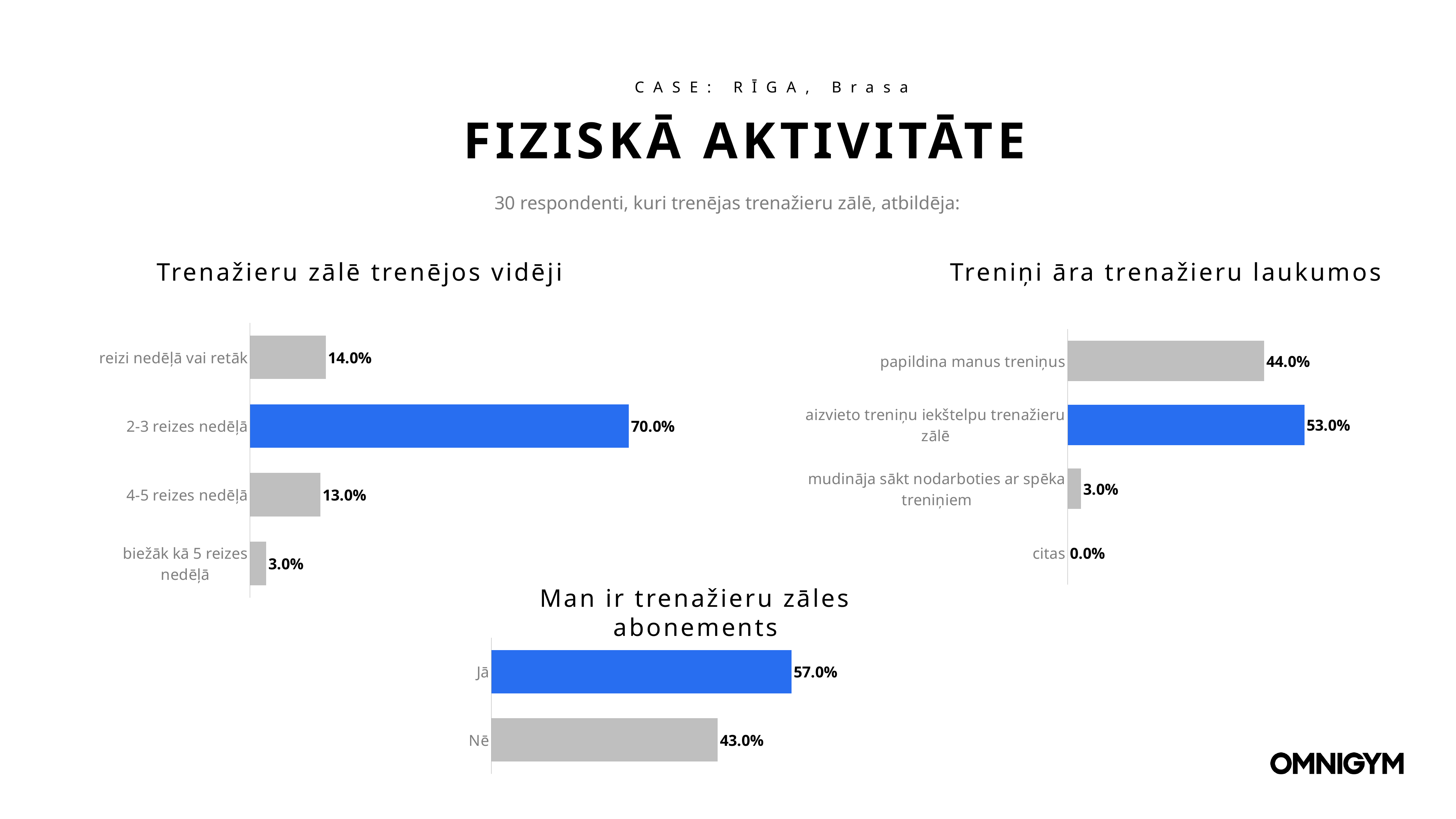
In the 'Trenažieru zālē trenējos vidēji' chart, which category has the lowest value? biežāk kā 5 reizes nedēļā In the 'Trenažieru zālē trenējos vidēji' chart, what is the value for '2-3 reizes nedēļā'? 70.0% In the 'Treniņi āra trenažieru laukumos' chart, what is the difference between 'aizvieto treniņu iekštelpu trenažieru zālē' and 'papildina manus treniņus'? 9.0% In the 'Treniņi āra trenažieru laukumos' chart, what is the value for 'papildina manus treniņus'? 44.0% In the 'Treniņi āra trenažieru laukumos' chart, what is the value for 'citas'? 0.0% In the 'Man ir trenažieru zāles abonements' chart, what is the value for 'Nē'? 43.0% In the 'Treniņi āra trenažieru laukumos' chart, which category has the highest value? aizvieto treniņu iekštelpu trenažieru zālē In the 'Trenažieru zālē trenējos vidēji' chart, which bar is coloured blue? 2-3 reizes nedēļā In the 'Man ir trenažieru zāles abonements' chart, which is larger, 'Jā' or 'Nē'? Jā In the 'Trenažieru zālē trenējos vidēji' chart, how many categories are shown? 4 What kind of chart is 'Man ir trenažieru zāles abonements'? bar chart In the 'Trenažieru zālē trenējos vidēji' chart, what is the difference between 'reizi nedēļā vai retāk' and '4-5 reizes nedēļā'? 1.0%